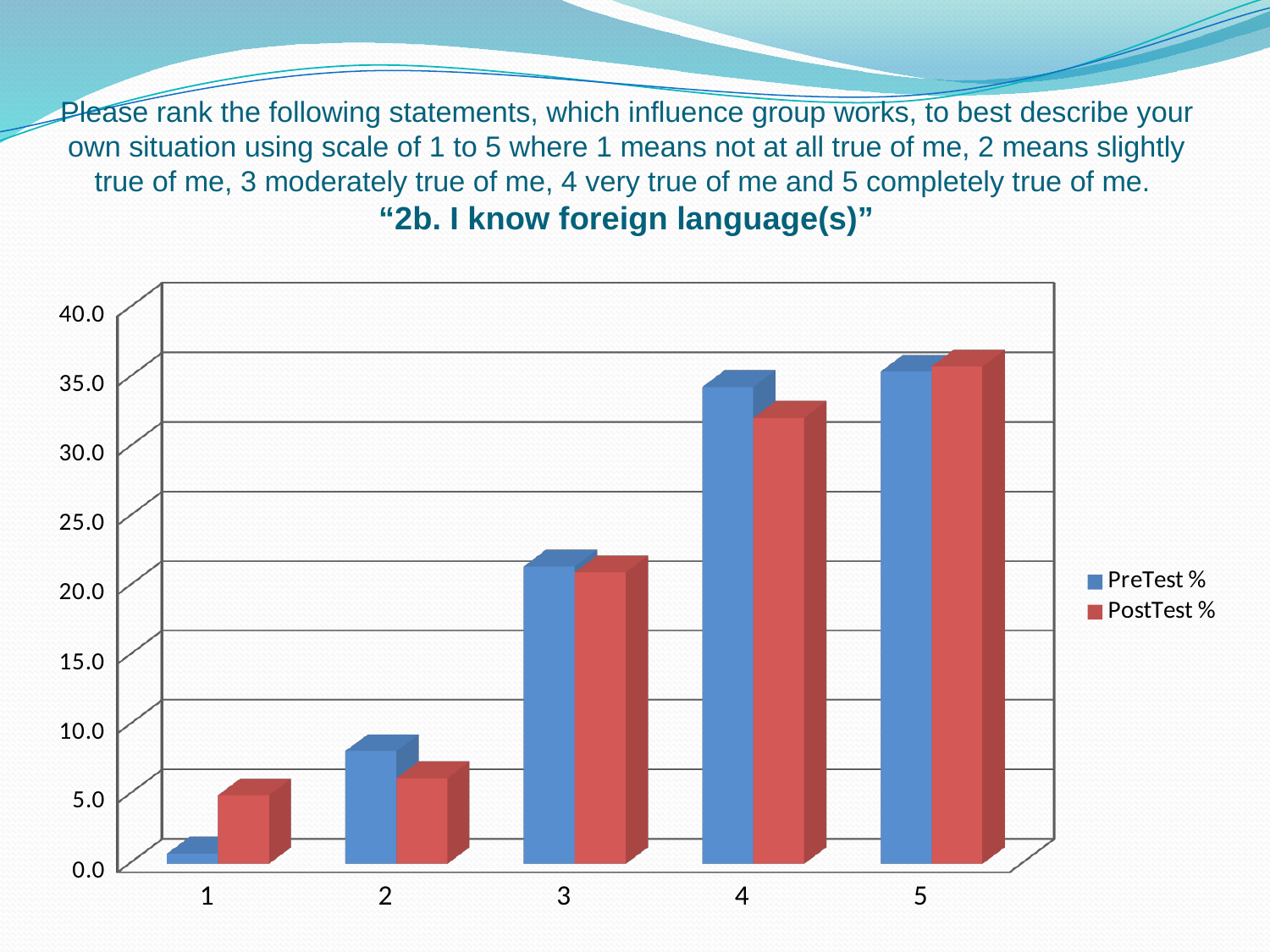
Do the PreTest % values rise or fall from category 1 to category 5? rise Is the PostTest % value for category 3 greater or less than 25.0? less How many categories are shown on the x axis? 5 For category 1, which is larger: PreTest % or PostTest %? PostTest % What colour are the PostTest % bars? red For category 2, which is larger: PreTest % or PostTest %? PreTest % How many series does the legend list? 2 For category 4, which is larger: PreTest % or PostTest %? PreTest % Is the PreTest % value for category 4 greater or less than 30.0? greater Which category has the lowest PreTest % value? 1 Which category has the highest PostTest % value? 5 What kind of chart is shown on the slide? bar chart